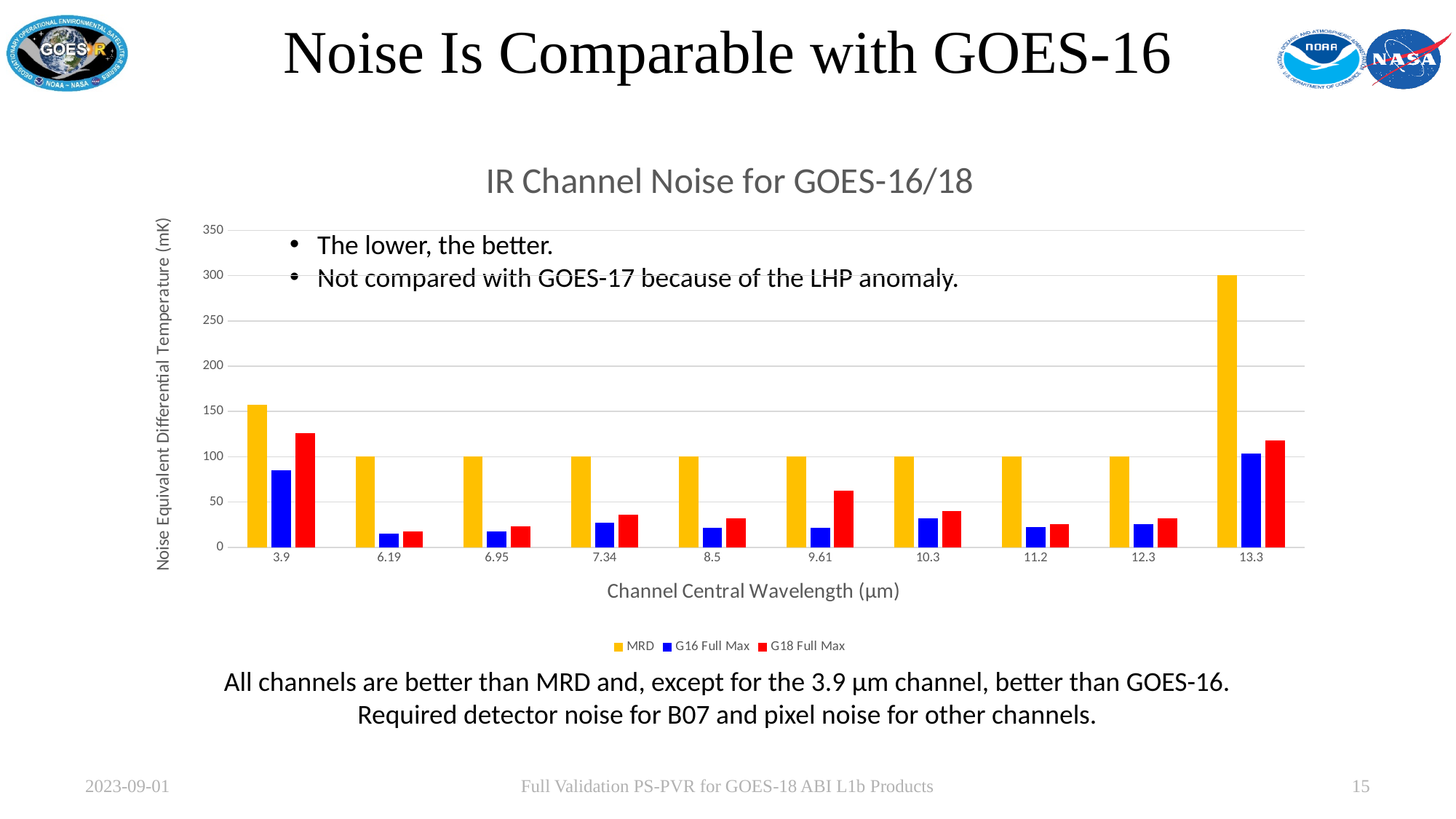
Is the G18 Full Max value for the 3.9 µm channel greater or less than 100? greater What is the MRD value for the 6.19 µm channel? 100 What is the MRD value for the 13.3 µm channel? 300 How many series does the legend list? 3 For which channel central wavelength is the MRD value highest? 13.3 What is the title of the chart? IR Channel Noise for GOES-16/18 What is the x-axis title of the chart? Channel Central Wavelength (µm) Is the G18 Full Max value for the 9.61 µm channel greater or less than 50? greater What kind of chart is shown on the slide? bar chart How many channel central wavelength categories are shown on the x axis? 10 Is the G16 Full Max value for the 3.9 µm channel greater or less than 100? less For the 3.9 µm channel, which is larger: G16 Full Max or G18 Full Max? G18 Full Max